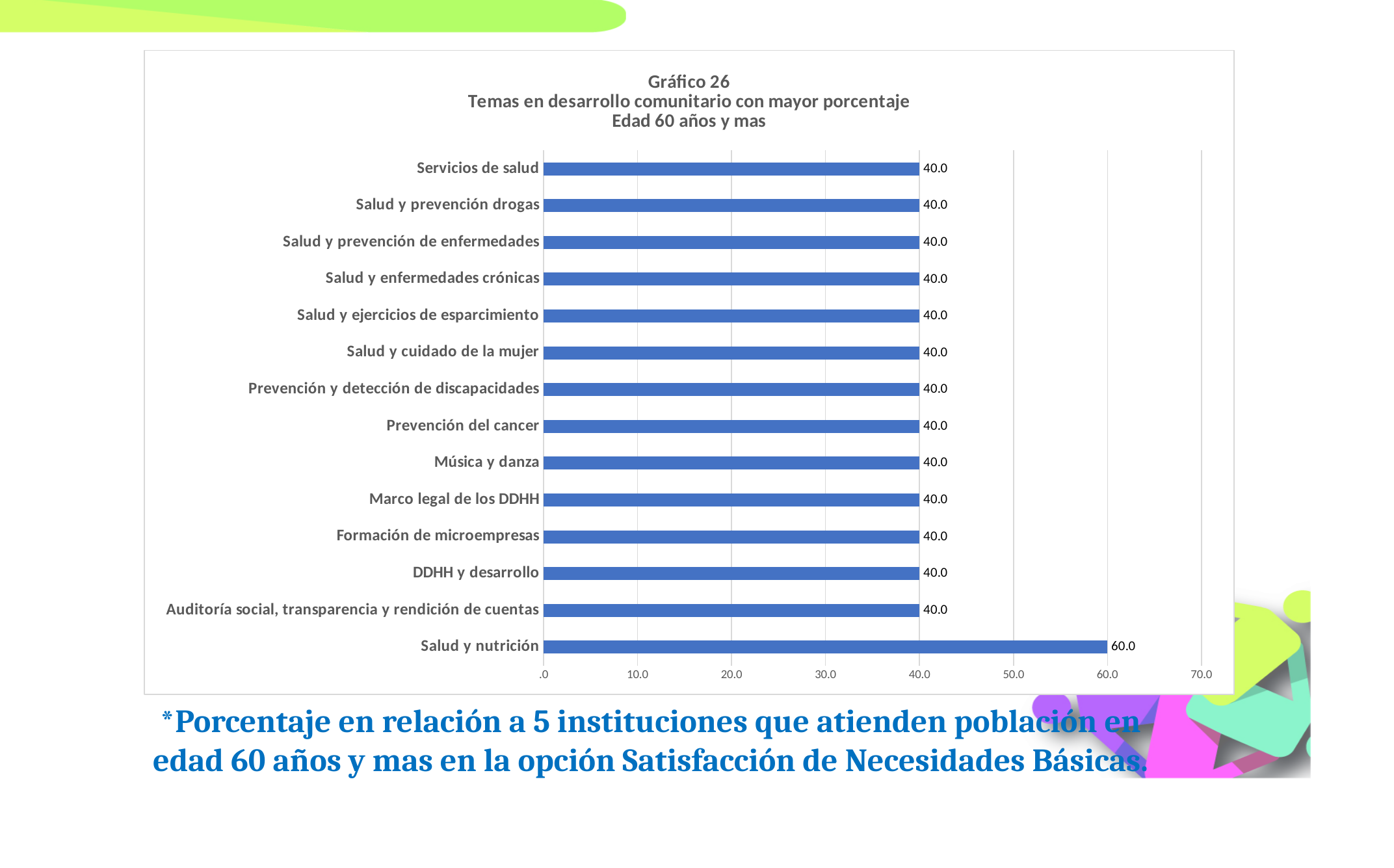
What is the chart number given in the title? Gráfico 26 How many categories are shown in the chart? 14 Is the value for Salud y nutrición greater or less than 50.0? greater What is the difference between the values for Salud y nutrición and Música y danza? 20.0 What type of chart is shown on the slide? bar chart What is the value for Marco legal de los DDHH? 40.0 What is the value for Auditoría social, transparencia y rendición de cuentas? 40.0 Which category has the highest value? Salud y nutrición What is the value for Salud y nutrición? 60.0 What is the value for Servicios de salud? 40.0 Which is larger, the value for Salud y nutrición or the value for DDHH y desarrollo? Salud y nutrición Is the value for Prevención del cancer greater or less than 50.0? less